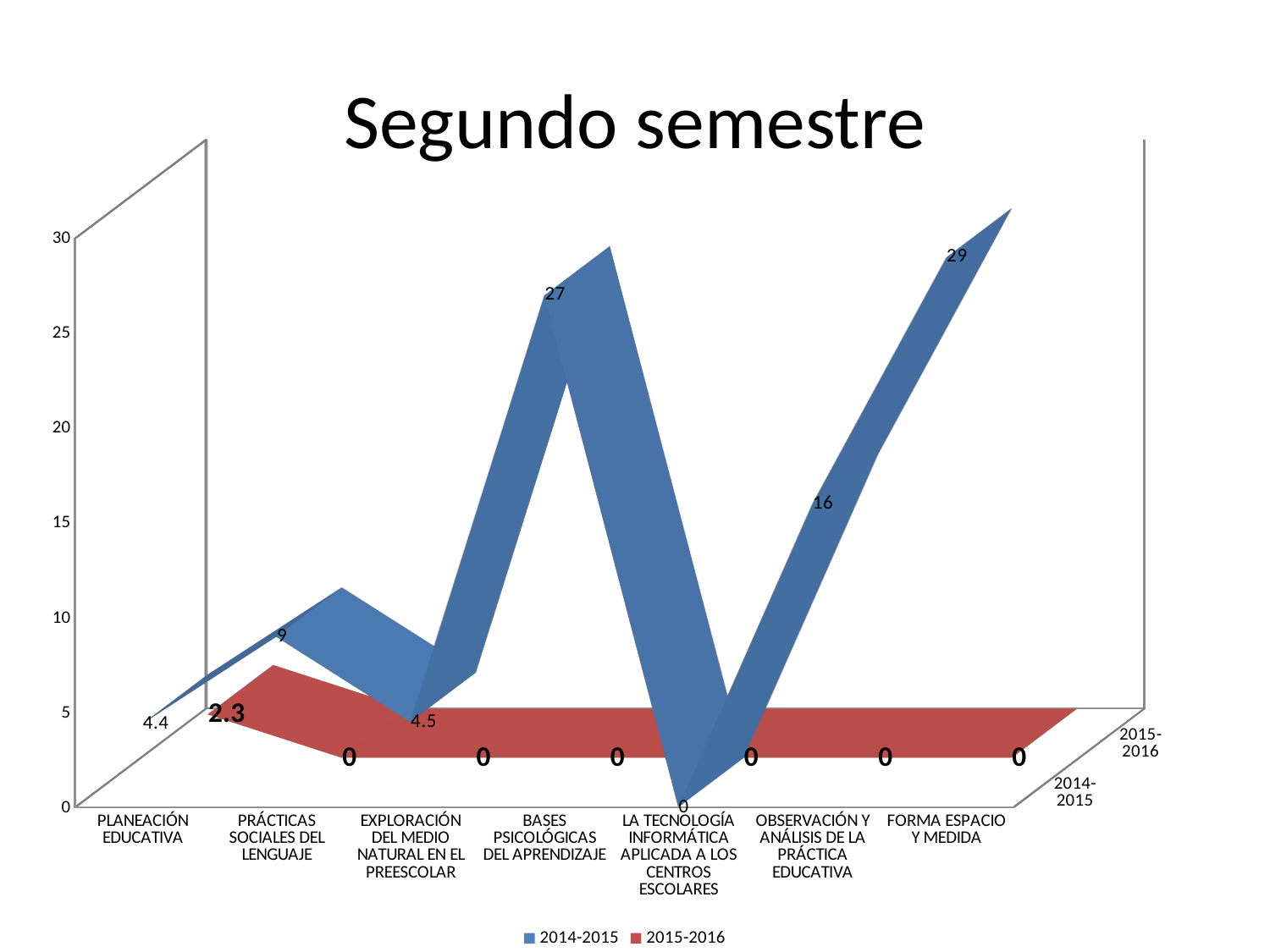
Which category has the lowest value in the 2014-2015 series? LA TECNOLOGÍA INFORMÁTICA APLICADA A LOS CENTROS ESCOLARES Which category has the highest value in the 2014-2015 series? FORMA ESPACIO Y MEDIDA What is the title of the chart? Segundo semestre What kind of chart is shown on the slide? 3D line chart In the 2014-2015 series, which is larger: PRÁCTICAS SOCIALES DEL LENGUAJE or EXPLORACIÓN DEL MEDIO NATURAL EN EL PREESCOLAR? PRÁCTICAS SOCIALES DEL LENGUAJE What is the value for PLANEACIÓN EDUCATIVA in the 2015-2016 series? 2.3 What is the value for OBSERVACIÓN Y ANÁLISIS DE LA PRÁCTICA EDUCATIVA in the 2014-2015 series? 16 What is the value for PLANEACIÓN EDUCATIVA in the 2014-2015 series? 4.4 What is the difference between the 2014-2015 values for FORMA ESPACIO Y MEDIDA and BASES PSICOLÓGICAS DEL APRENDIZAJE? 2 How many categories are shown on the x axis? 7 What is the value for BASES PSICOLÓGICAS DEL APRENDIZAJE in the 2014-2015 series? 27 How many series does the legend list? 2